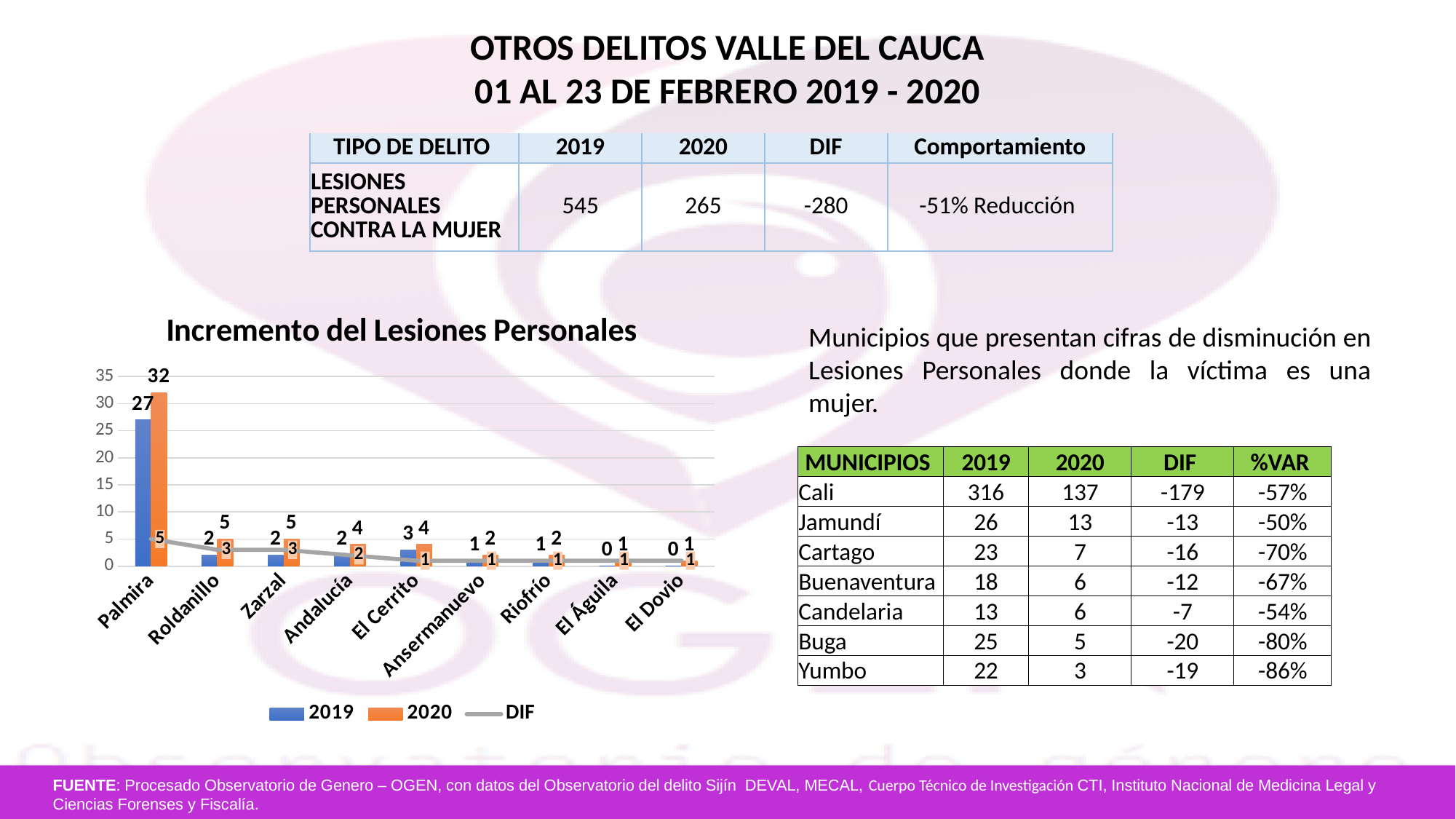
What is the DIF value for Roldanillo in the chart? 3 What is the 2019 value for El Cerrito in the chart? 3 What is the title of the chart? Incremento del Lesiones Personales What is the 2019 value for El Dovio in the chart? 0 In the chart, is the 2019 value for Andalucía or the 2019 value for El Cerrito larger? El Cerrito What is the difference between the 2020 and 2019 values for Palmira in the chart? 5 Which municipality has the highest 2020 value in the chart? Palmira What is the 2020 value for Palmira in the chart? 32 What kind of chart is shown on the slide? Bar chart with a line How many municipalities are shown on the x axis of the chart? 9 Is the 2020 value for Palmira greater or less than 30? greater How many series does the chart legend list? 3